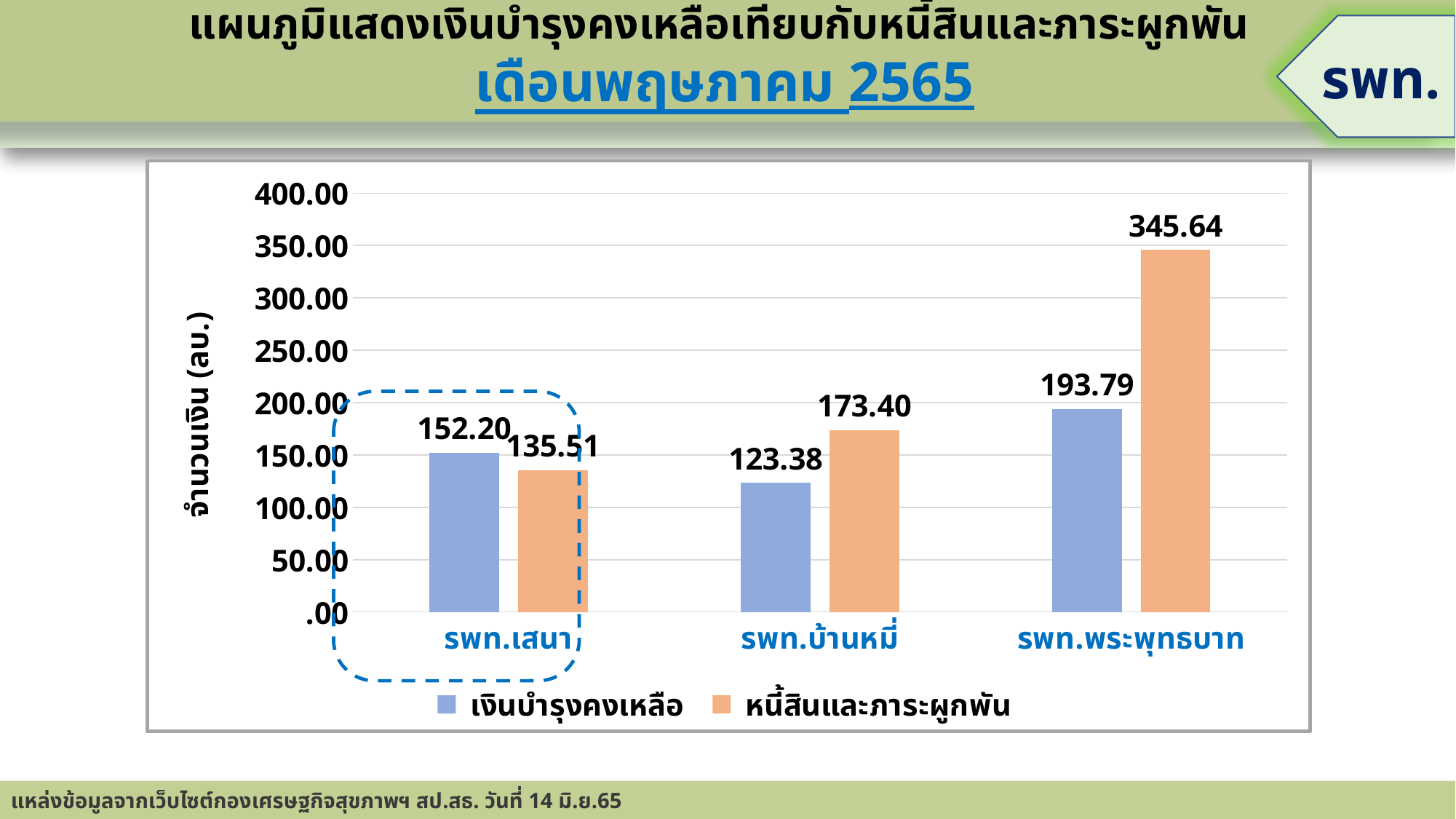
How many series does the legend list? 2 Is the value of เงินบำรุงคงเหลือ for รพท.บ้านหมี่ greater or less than 150.00? less What is the difference between หนี้สินและภาระผูกพัน and เงินบำรุงคงเหลือ for รพท.พระพุทธบาท? 151.85 How many hospitals are shown on the x axis of the chart? 3 Which hospital has the lowest เงินบำรุงคงเหลือ? รพท.บ้านหมี่ What is the label of the y axis? จำนวนเงิน (ลบ.) What is the value of เงินบำรุงคงเหลือ for รพท.เสนา? 152.20 For รพท.เสนา, which is larger: เงินบำรุงคงเหลือ or หนี้สินและภาระผูกพัน? เงินบำรุงคงเหลือ Which hospital has the highest หนี้สินและภาระผูกพัน? รพท.พระพุทธบาท What is the value of หนี้สินและภาระผูกพัน for รพท.บ้านหมี่? 173.40 What is the value of หนี้สินและภาระผูกพัน for รพท.พระพุทธบาท? 345.64 What kind of chart is shown on the slide? bar chart